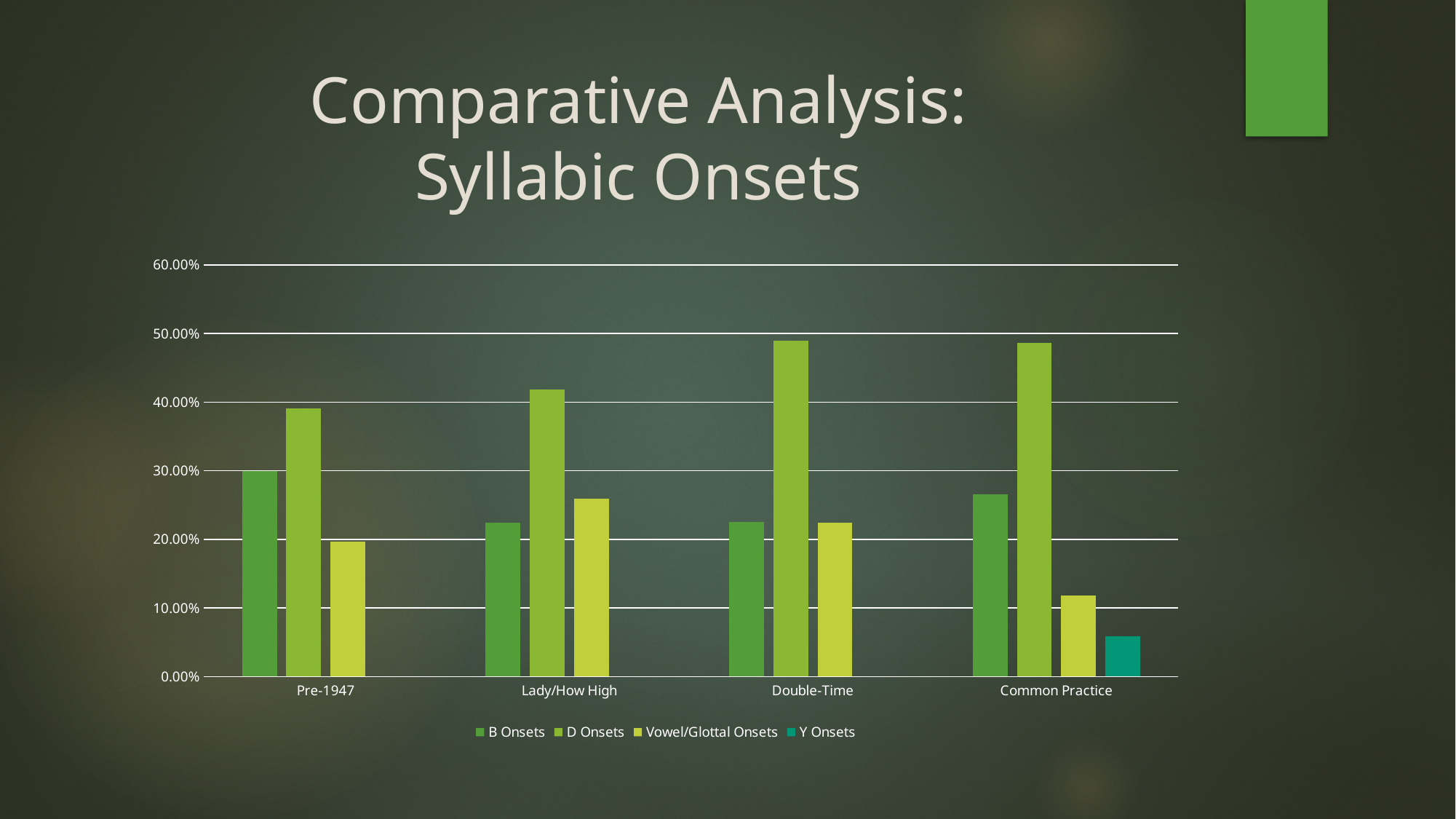
Is the value for Y Onsets in Common Practice greater or less than 10.00%? less Which category has the lowest value for Vowel/Glottal Onsets? Common Practice Is the value for D Onsets in Pre-1947 greater or less than 30.00%? greater Which is larger: D Onsets in Lady/How High or D Onsets in Pre-1947? Lady/How High Is the value for Vowel/Glottal Onsets in Common Practice greater or less than 20.00%? less Which series has the lowest value in the Common Practice category? Y Onsets Which category is the only one with a Y Onsets bar? Common Practice What kind of chart is shown on the slide? bar chart How many categories are shown on the x axis? 4 How many series does the legend list? 4 Which series has the highest value in the Pre-1947 category? D Onsets